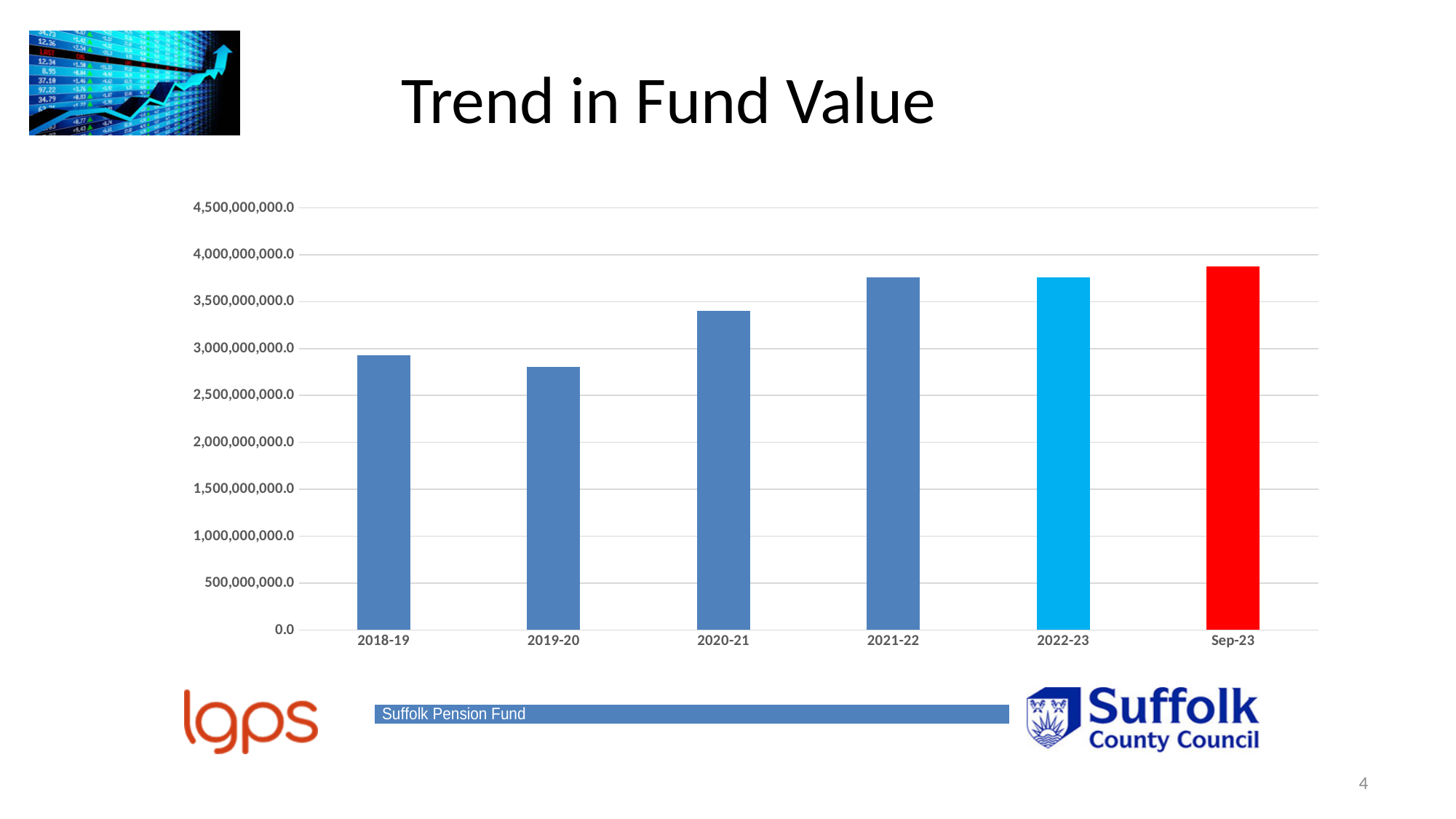
Does the fund value generally rise or fall from 2019-20 to Sep-23? rise Which period has the lowest fund value? 2019-20 Is the value for 2018-19 greater or less than 2,500,000,000.0? greater Is the value for 2021-22 greater or less than 3,500,000,000.0? greater Which period has the highest fund value? Sep-23 Which is larger, the value for 2020-21 or the value for 2019-20? 2020-21 Is the value for Sep-23 greater or less than 4,000,000,000.0? less What colour is the bar for Sep-23? red What kind of chart is shown on the slide? bar chart How many periods (bars) are shown on the chart? 6